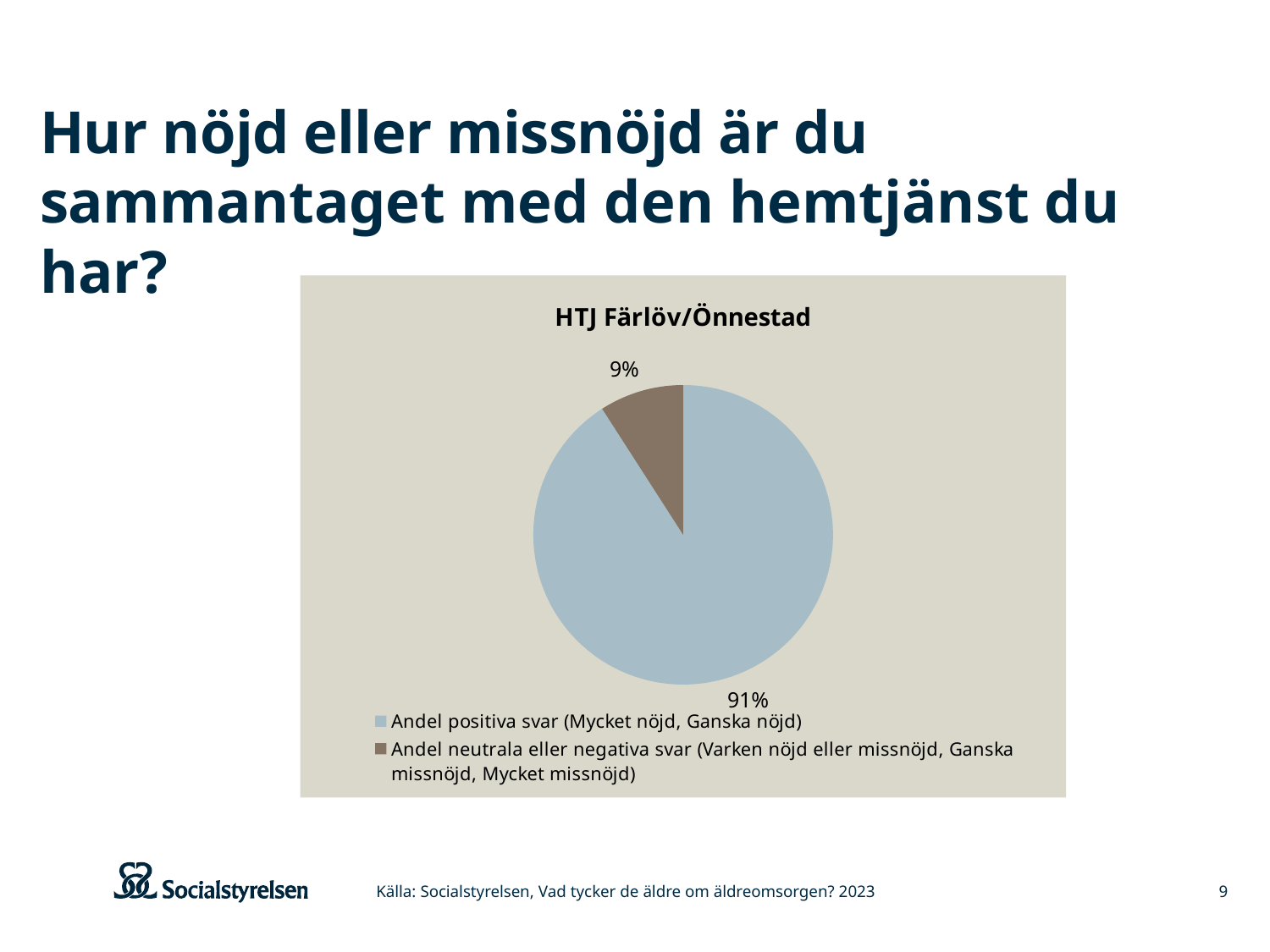
What share of the pie is 'Andel positiva svar (Mycket nöjd, Ganska nöjd)'? 91% How many entries does the legend list? 2 What colour is the slice for 'Andel positiva svar (Mycket nöjd, Ganska nöjd)'? light blue Which slice of the pie is the largest? Andel positiva svar (Mycket nöjd, Ganska nöjd) Which slice of the pie is the smallest? Andel neutrala eller negativa svar (Varken nöjd eller missnöjd, Ganska missnöjd, Mycket missnöjd) What is the chart's title? HTJ Färlöv/Önnestad What share of the pie is 'Andel neutrala eller negativa svar (Varken nöjd eller missnöjd, Ganska missnöjd, Mycket missnöjd)'? 9% How many slices does the pie chart have? 2 What kind of chart is shown on the slide? pie chart What is the difference in percentage points between the positive-answer slice and the neutral-or-negative-answer slice? 82 percentage points Which is larger: the share of positive answers or the share of neutral or negative answers? positive answers